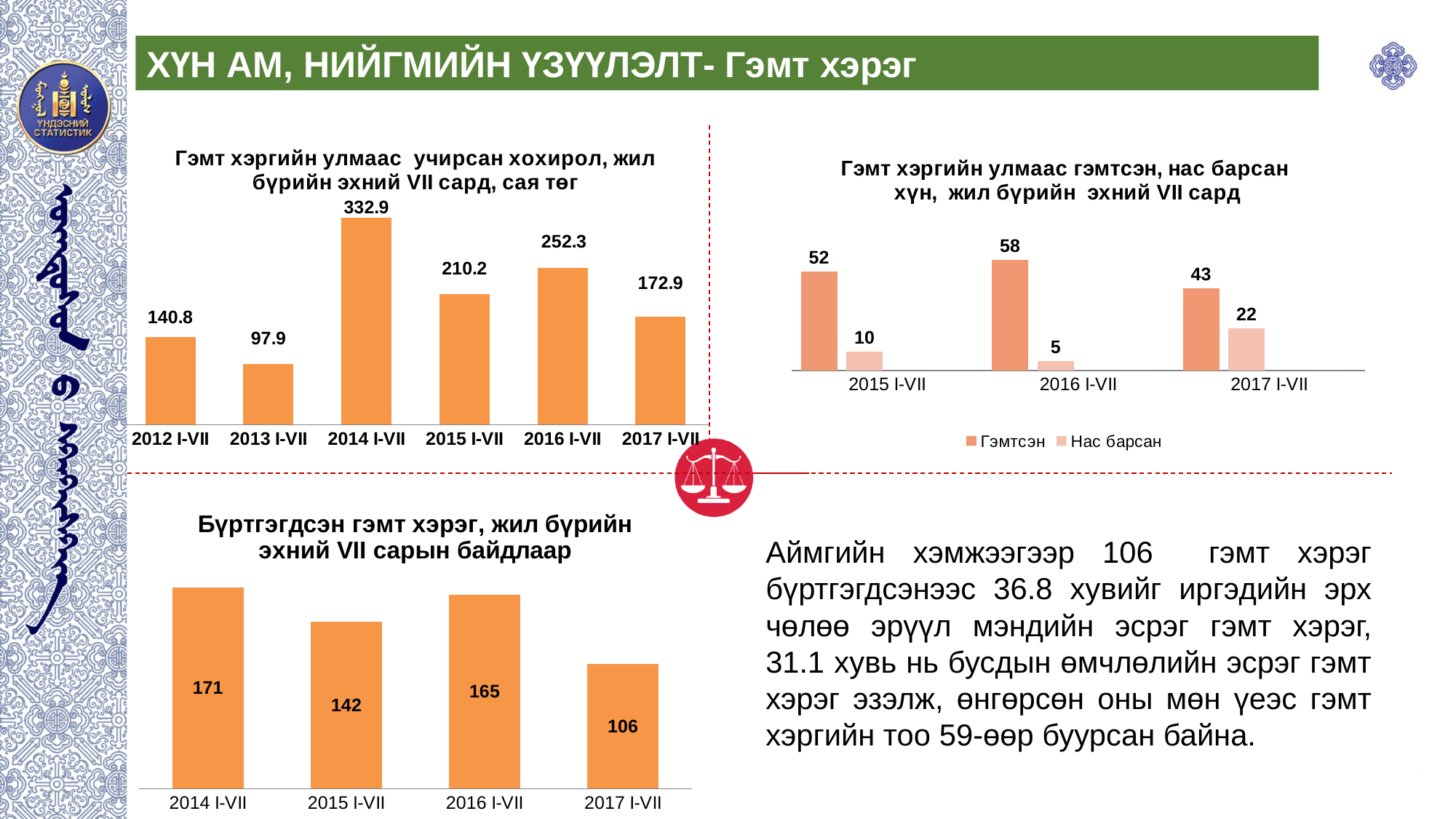
In the bottom-left chart (Бүртгэгдсэн гэмт хэрэг), what is the value for 2015 I-VII? 142 In the top-left chart (Гэмт хэргийн улмаас учирсан хохирол), what is the value for 2014 I-VII? 332.9 In the top-left chart (Гэмт хэргийн улмаас учирсан хохирол), which period has the lowest value? 2013 I-VII In the top-left chart (Гэмт хэргийн улмаас учирсан хохирол), what is the difference between the values for 2016 I-VII and 2017 I-VII? 79.4 In the top-right chart (Гэмт хэргийн улмаас гэмтсэн, нас барсан хүн), what is the difference between the Гэмтсэн and Нас барсан values for 2015 I-VII? 42 In the top-right chart (Гэмт хэргийн улмаас гэмтсэн, нас барсан хүн), which period has the highest Гэмтсэн value? 2016 I-VII In the top-right chart (Гэмт хэргийн улмаас гэмтсэн, нас барсан хүн), what is the Нас барсан value for 2017 I-VII? 22 In the bottom-left chart (Бүртгэгдсэн гэмт хэрэг), which is larger: the value for 2016 I-VII or 2017 I-VII? 2016 I-VII What kind of chart is the bottom-left chart (Бүртгэгдсэн гэмт хэрэг)? Bar chart In the top-right chart (Гэмт хэргийн улмаас гэмтсэн, нас барсан хүн), how many series does the legend list? 2 In the bottom-left chart (Бүртгэгдсэн гэмт хэрэг), which period has the highest value? 2014 I-VII In the top-left chart (Гэмт хэргийн улмаас учирсан хохирол), how many periods are shown on the x axis? 6